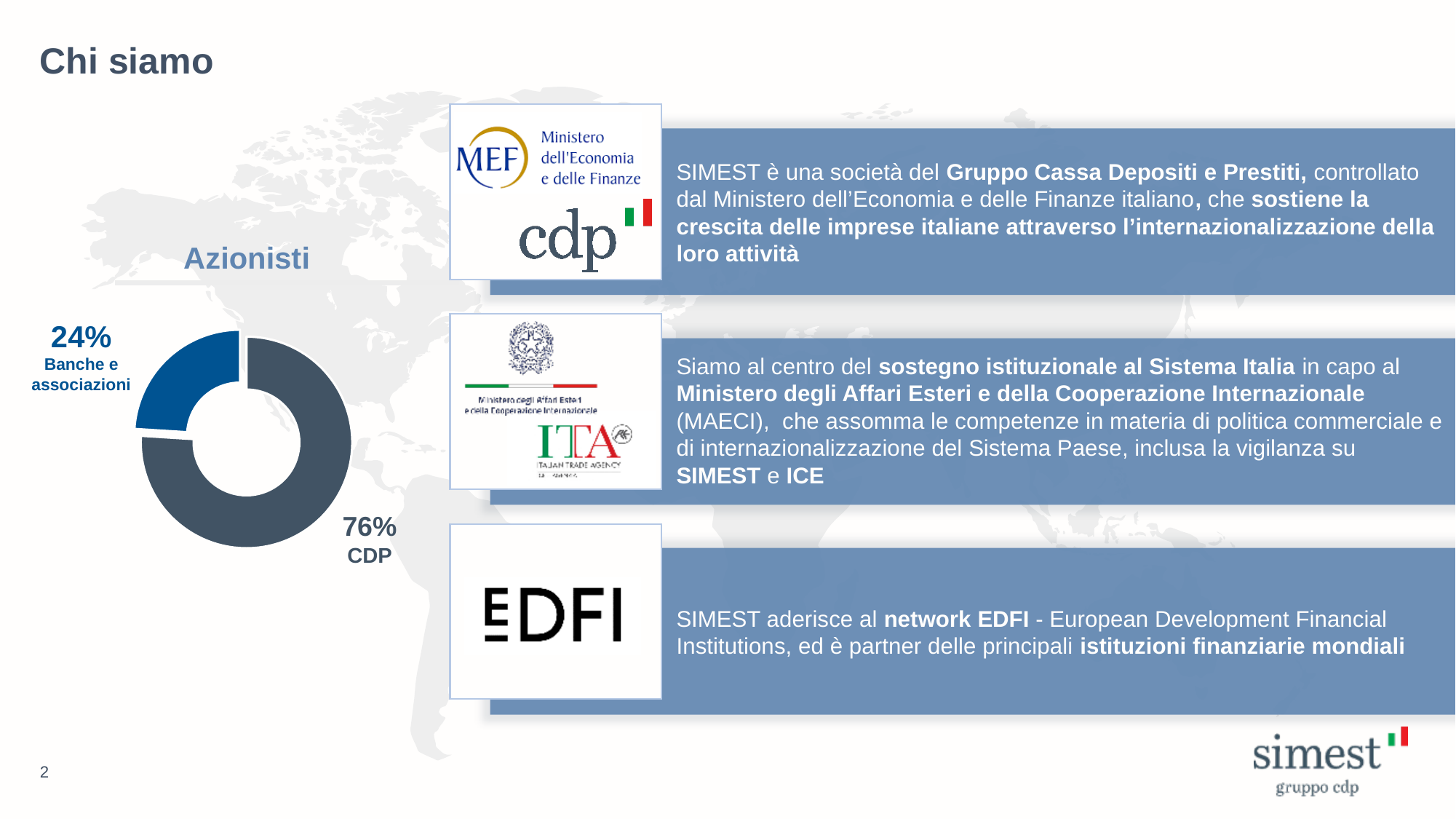
Which is larger: the share of CDP or the share of Banche e associazioni? CDP Which category is shown in the lighter blue segment of the Azionisti chart? Banche e associazioni What is the title of the chart on the left of the slide? Azionisti What is the difference in percentage points between the CDP share and the Banche e associazioni share? 52 How many categories are shown in the Azionisti chart? 2 What is the total of the two shares shown in the Azionisti chart? 100% What share of the Azionisti chart do Banche e associazioni hold? 24% What kind of chart is used to show the Azionisti breakdown? Doughnut chart Which shareholder category has the smallest share in the Azionisti chart? Banche e associazioni Which shareholder category has the largest share in the Azionisti chart? CDP What share of the Azionisti chart does CDP hold? 76%